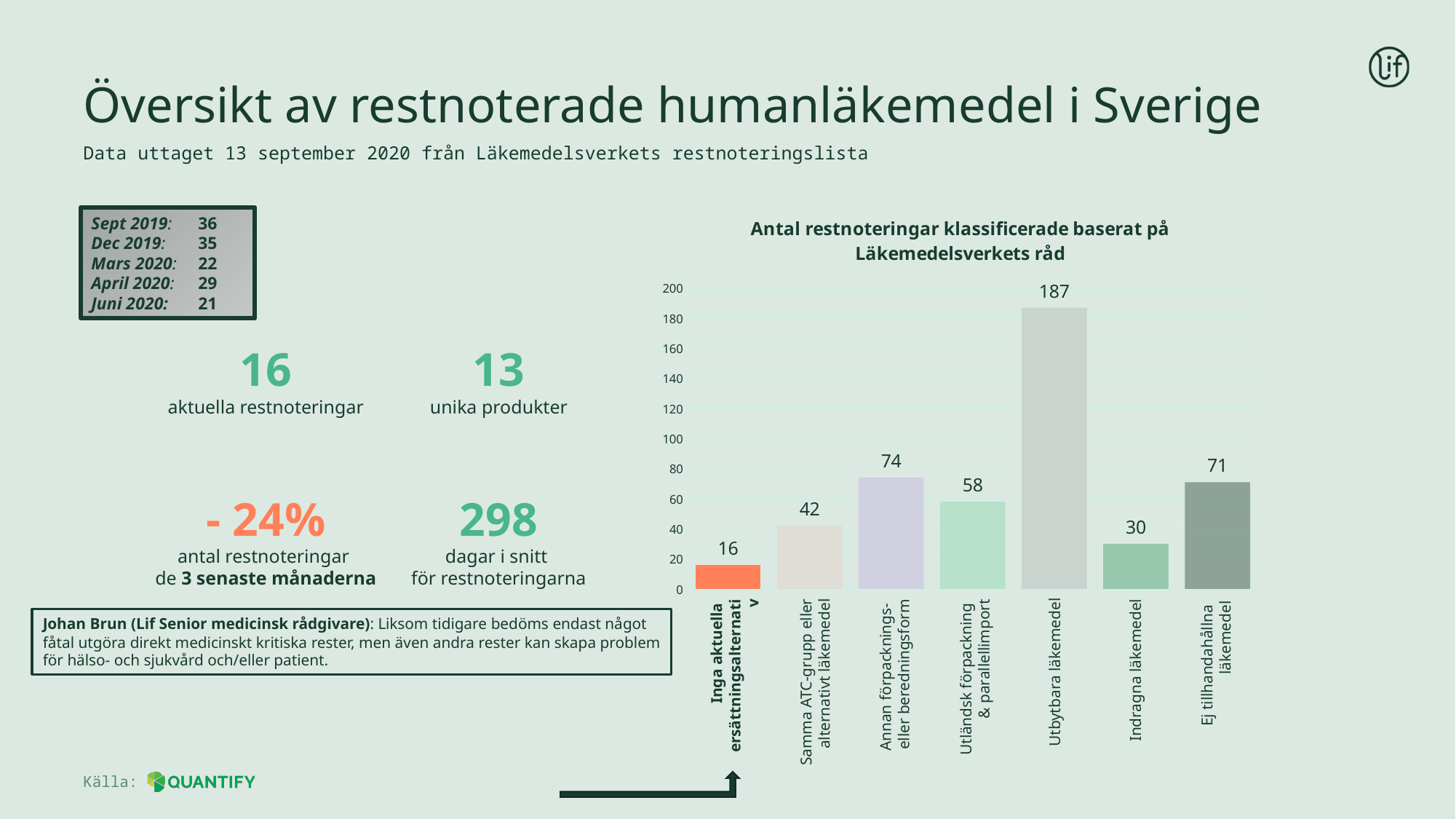
How many categories are shown in the chart? 7 What is the value for Samma ATC-grupp eller alternativt läkemedel? 42 Which category has the highest value? Utbytbara läkemedel What is the difference between Annan förpacknings- eller beredningsform and Utländsk förpackning & parallellimport? 16 What is the title of the chart? Antal restnoteringar klassificerade baserat på Läkemedelsverkets råd What kind of chart is shown? Bar chart What is the value for Ej tillhandahållna läkemedel? 71 Which category has the lowest value? Inga aktuella ersättningsalternativ What is the value for Indragna läkemedel? 30 What is the value for Utbytbara läkemedel? 187 Which is larger, Samma ATC-grupp eller alternativt läkemedel or Indragna läkemedel? Samma ATC-grupp eller alternativt läkemedel What is the difference between Utbytbara läkemedel and Ej tillhandahållna läkemedel? 116